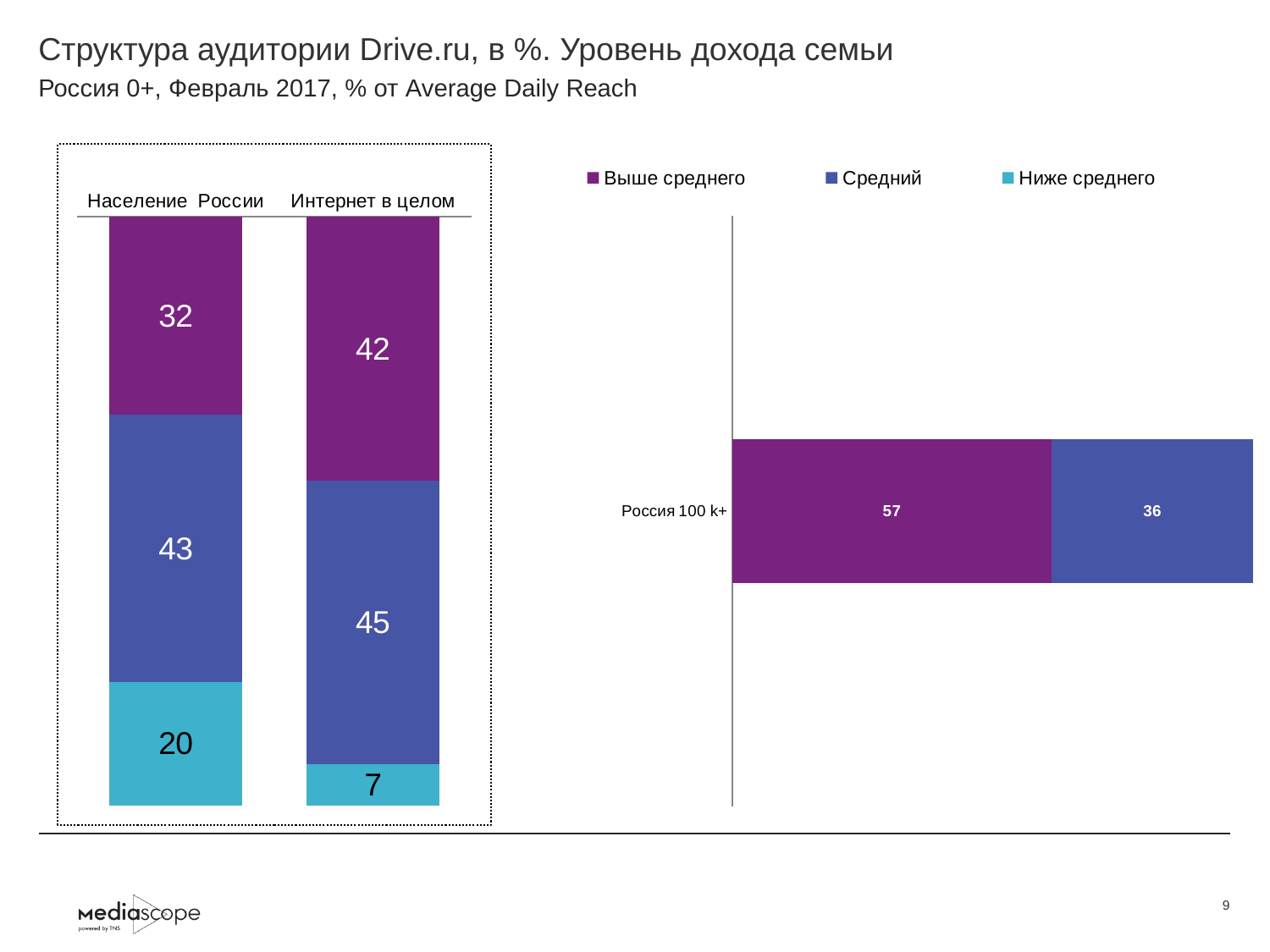
In the left chart, which segment is the smallest for Население России? Ниже среднего In the left chart, which is larger: Ниже среднего for Население России or Ниже среднего for Интернет в целом? Население России In the left chart, what is the value of Ниже среднего for Интернет в целом? 7 What kind of chart is the right chart? Stacked horizontal bar chart In the right chart, what is the value of Средний for Россия 100 k+? 36 In the right chart, which is larger for Россия 100 k+: Выше среднего or Средний? Выше среднего In the right chart, what is the value of Выше среднего for Россия 100 k+? 57 In the left chart, what is the value of Средний for Население России? 43 In the left chart, what is the total of the stacked bar for Население России? 95 In the left chart, which segment is the largest for Интернет в целом? Средний How many series does the legend list? 3 In the left chart, what is the difference between Выше среднего for Интернет в целом and Выше среднего for Население России? 10